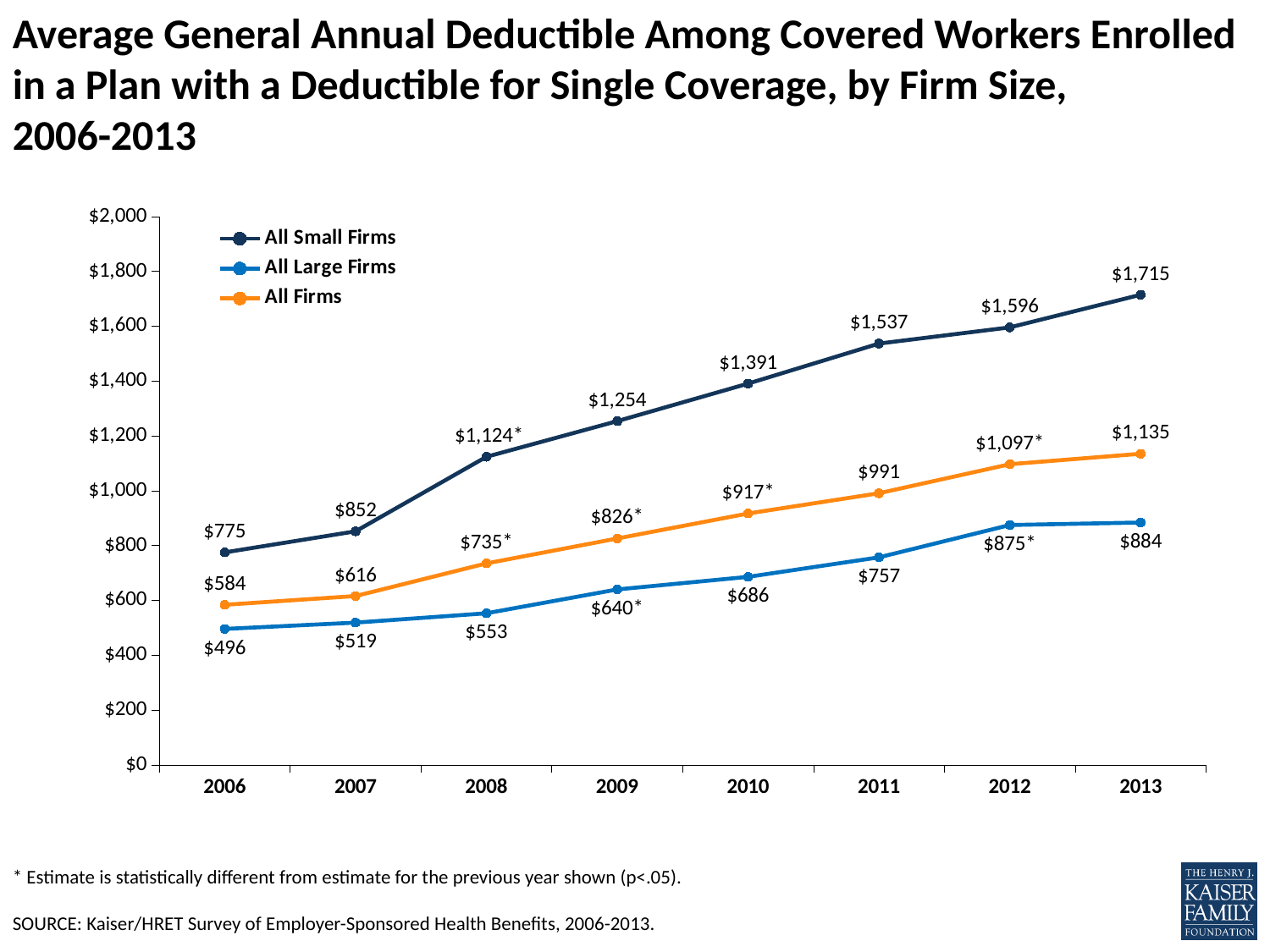
What kind of chart is shown on the slide? line chart How many years are shown on the x axis? 8 What is the average deductible for All Small Firms in 2013? $1,715 How many series does the legend list? 3 What is the difference between the All Small Firms and All Large Firms deductibles in 2013? $831 Does the All Firms deductible rise or fall from 2006 to 2013? rise Which is larger in 2009: the All Firms deductible or the All Large Firms deductible? All Firms In which year is the All Small Firms deductible highest? 2013 What is the average deductible for All Large Firms in 2006? $496 In which year is the All Large Firms deductible lowest? 2006 What is the average deductible for All Firms in 2010? $917 Is the All Small Firms deductible in 2011 greater or less than $1,400? greater